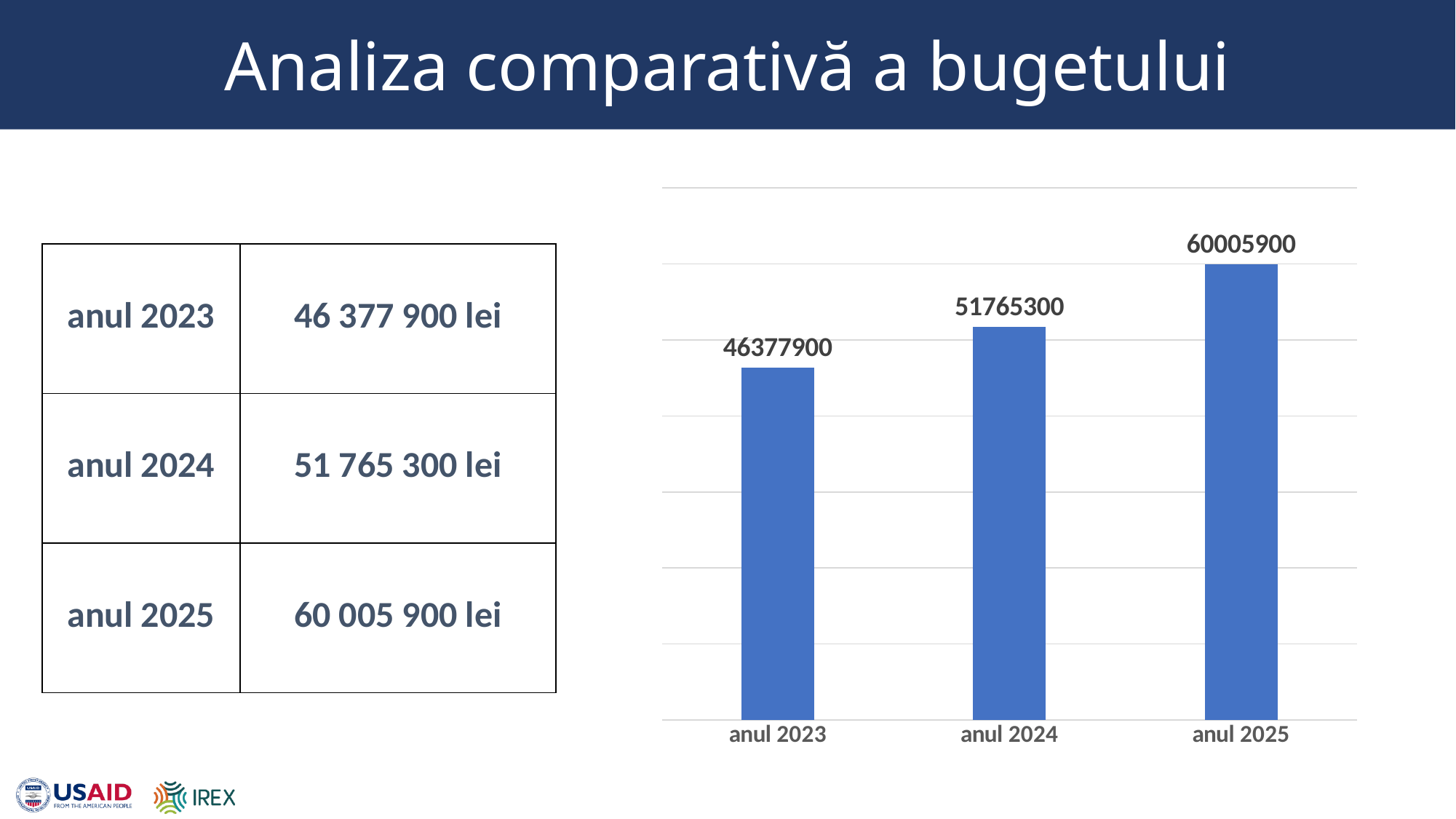
What is the value of the bar for anul 2025? 60005900 What is the difference between the values for anul 2024 and anul 2023? 5387400 What is the value of the bar for anul 2024? 51765300 What is the difference between the values for anul 2025 and anul 2023? 13628000 What is the value of the bar for anul 2023? 46377900 What is the difference between the values for anul 2025 and anul 2024? 8240600 Which year has the lowest bar in the chart? anul 2023 How many bars are shown in the chart? 3 Do the values rise or fall from anul 2023 to anul 2025? rise Which year has the highest bar in the chart? anul 2025 Which is larger, the value for anul 2024 or the value for anul 2023? anul 2024 What type of chart is shown on the slide? bar chart